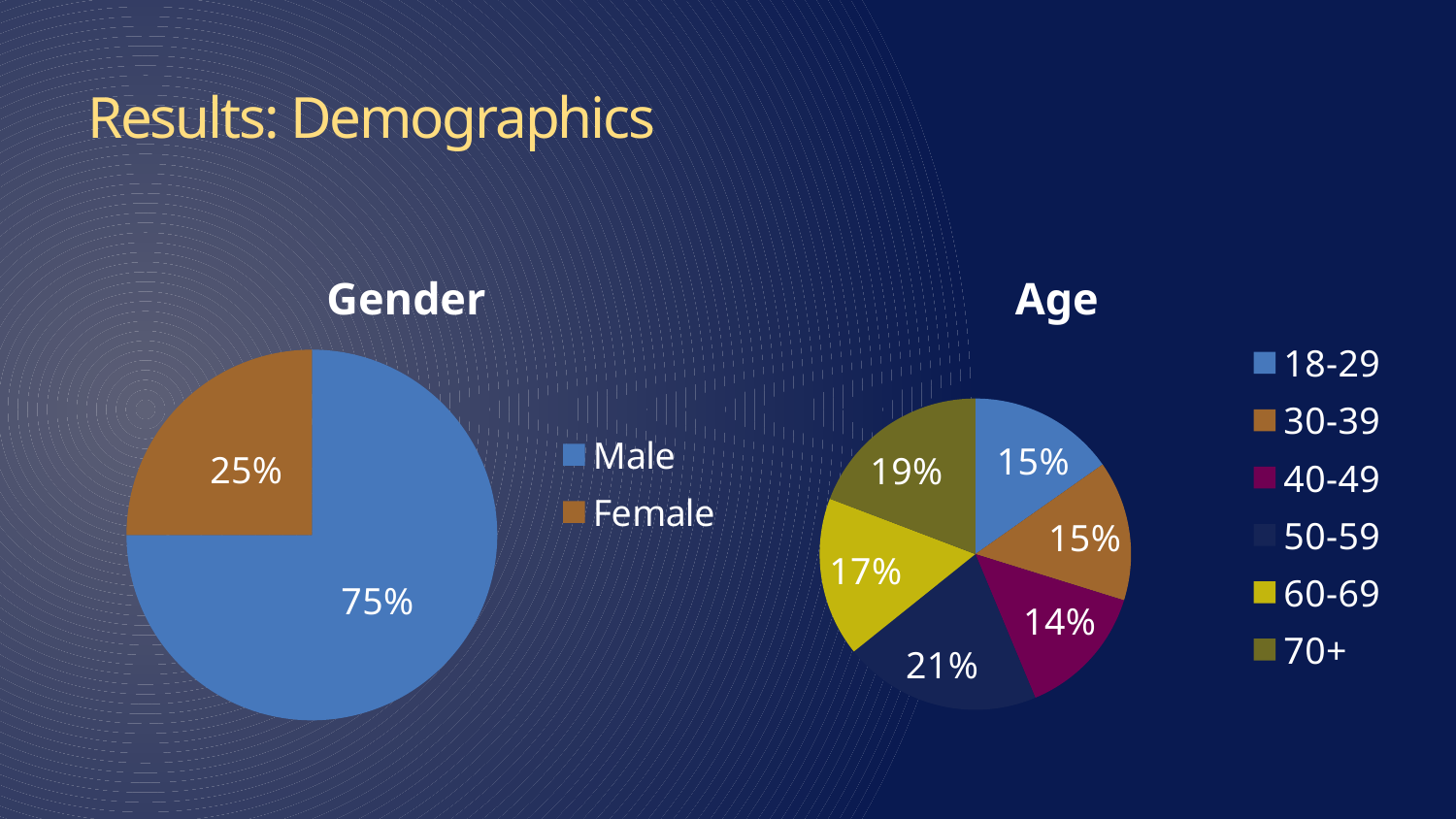
In the Age chart, what colour is the 60-69 slice? Yellow In the Gender chart, what is the difference between the Male and Female shares? 50% In the Age chart, how many age groups are shown? 6 In the Gender chart, what share of respondents are Male? 75% In the Age chart, which age group has the largest share? 50-59 In the Age chart, what is the difference between the 50-59 share and the 40-49 share? 7% In the Age chart, what share of respondents are aged 70+? 19% In the Gender chart, what share of respondents are Female? 25% In the Age chart, which age group has the smallest share? 40-49 In the Age chart, what share of respondents are aged 50-59? 21% What kind of chart is the Gender chart? Pie chart In the Age chart, which is larger, the share for 60-69 or the share for 70+? 70+